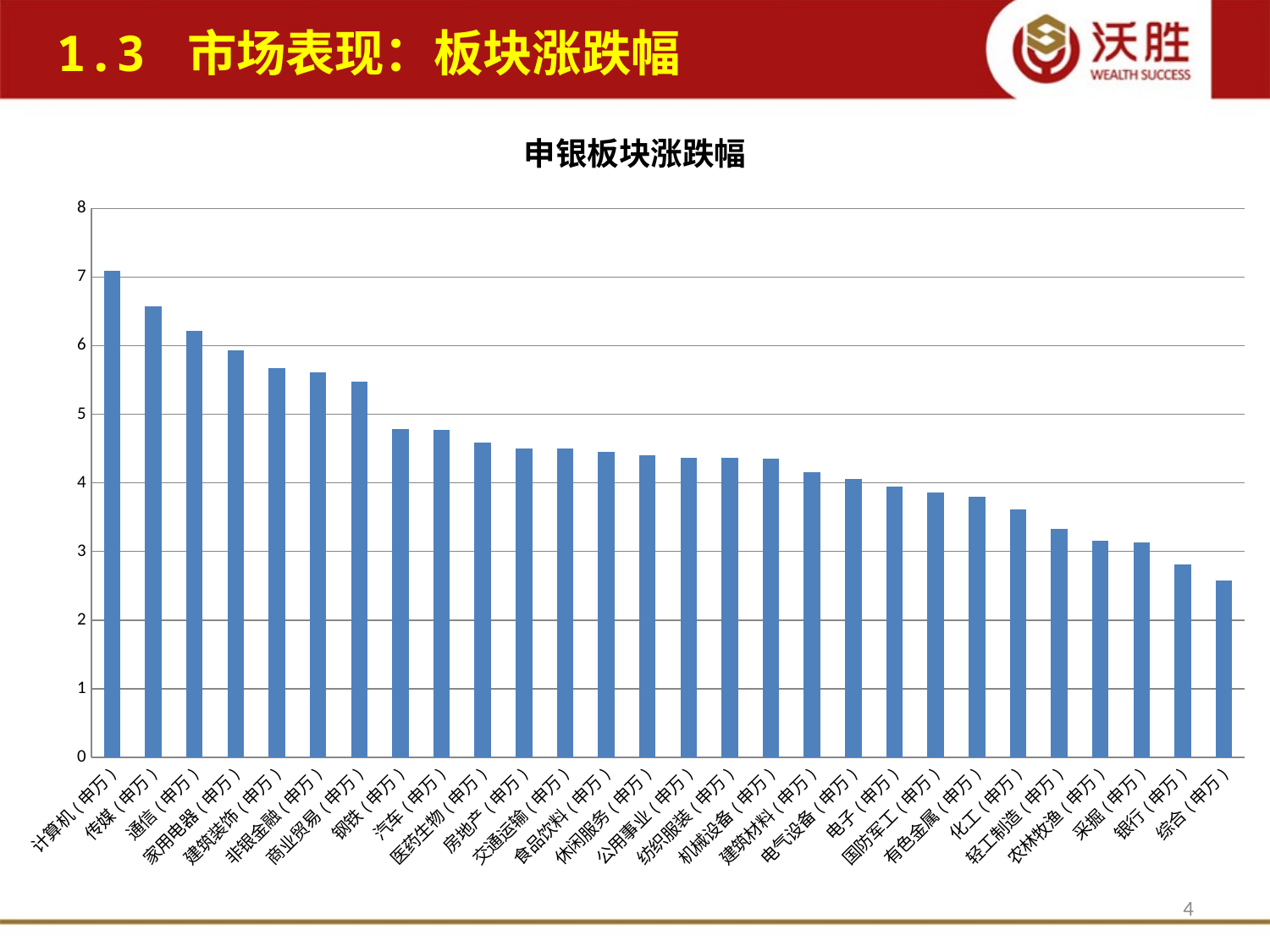
Is the value for 计算机（申万） greater or less than 7? greater Which is larger, the value for 通信（申万） or the value for 化工（申万）? 通信（申万） How many categories are plotted in the chart? 28 Is the value for 综合（申万） greater or less than 3? less Do the values generally rise or fall from left to right along the x axis? fall What is the title of the chart? 申银板块涨跌幅 Which category has the lowest value? 综合（申万） What kind of chart is shown on the slide? bar chart Is the value for 银行（申万） greater or less than 3? less Which category has the highest value? 计算机（申万）